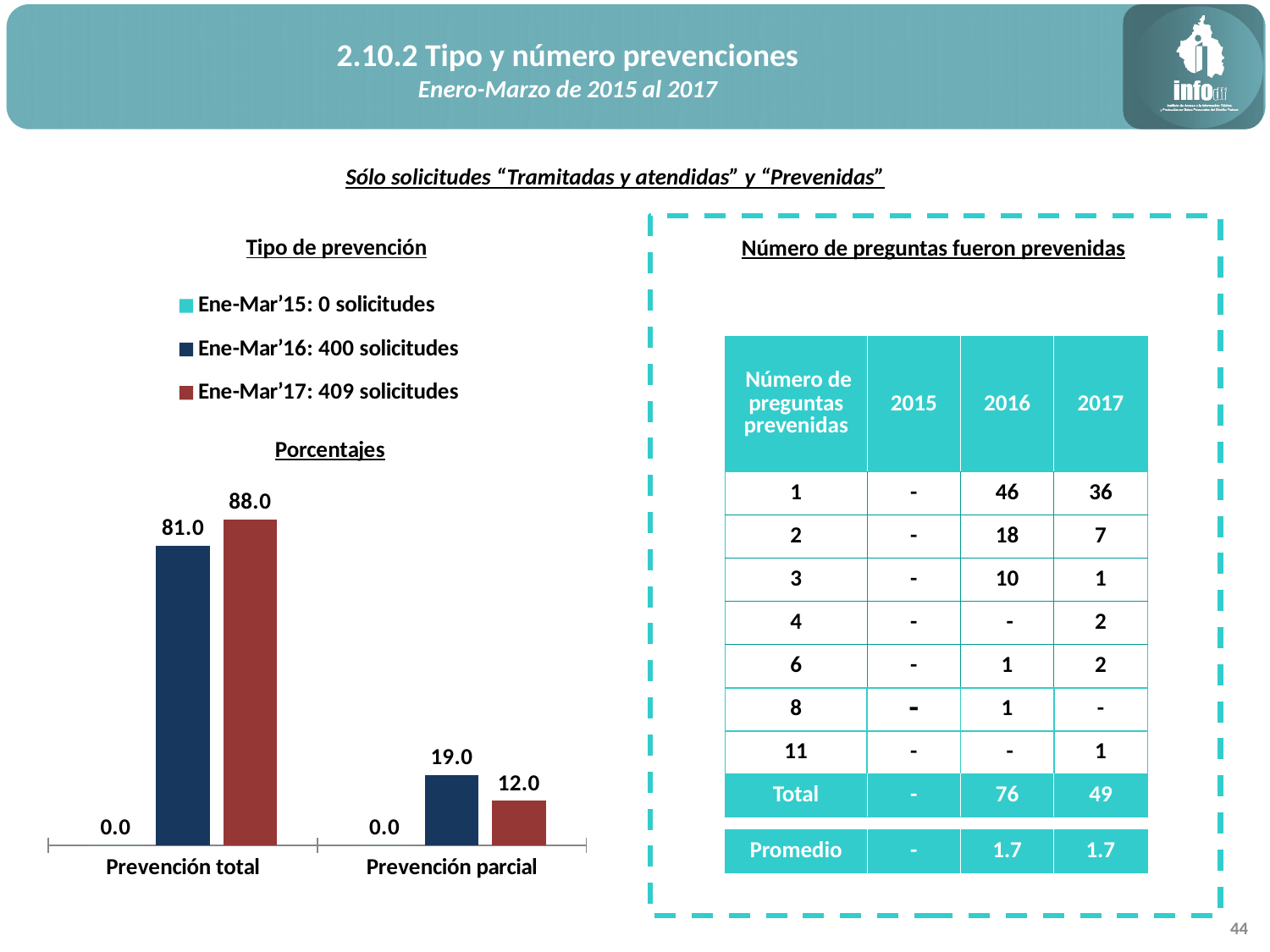
In the "Tipo de prevención" chart, what is the value for Ene-Mar'17 in Prevención parcial? 12.0 In the "Tipo de prevención" chart, which series has the highest value in Prevención total? Ene-Mar'17 How many series does the legend of the "Tipo de prevención" chart list? 3 In the "Tipo de prevención" chart, what is the value for Ene-Mar'16 in Prevención parcial? 19.0 In the "Tipo de prevención" chart, what is the value for Ene-Mar'16 in Prevención total? 81.0 In the "Tipo de prevención" chart, what is the difference between the Ene-Mar'16 and Ene-Mar'17 values in Prevención parcial? 7.0 In the "Tipo de prevención" chart, what is the difference between the Ene-Mar'17 and Ene-Mar'16 values in Prevención total? 7.0 How many categories are shown on the x axis of the "Tipo de prevención" chart? 2 In the "Tipo de prevención" chart, what is the value for Ene-Mar'17 in Prevención total? 88.0 What kind of chart is shown under "Tipo de prevención"? bar chart In the "Tipo de prevención" chart, what is the value for Ene-Mar'15 in Prevención total? 0.0 In the "Tipo de prevención" chart, which series has the highest value in Prevención parcial? Ene-Mar'16